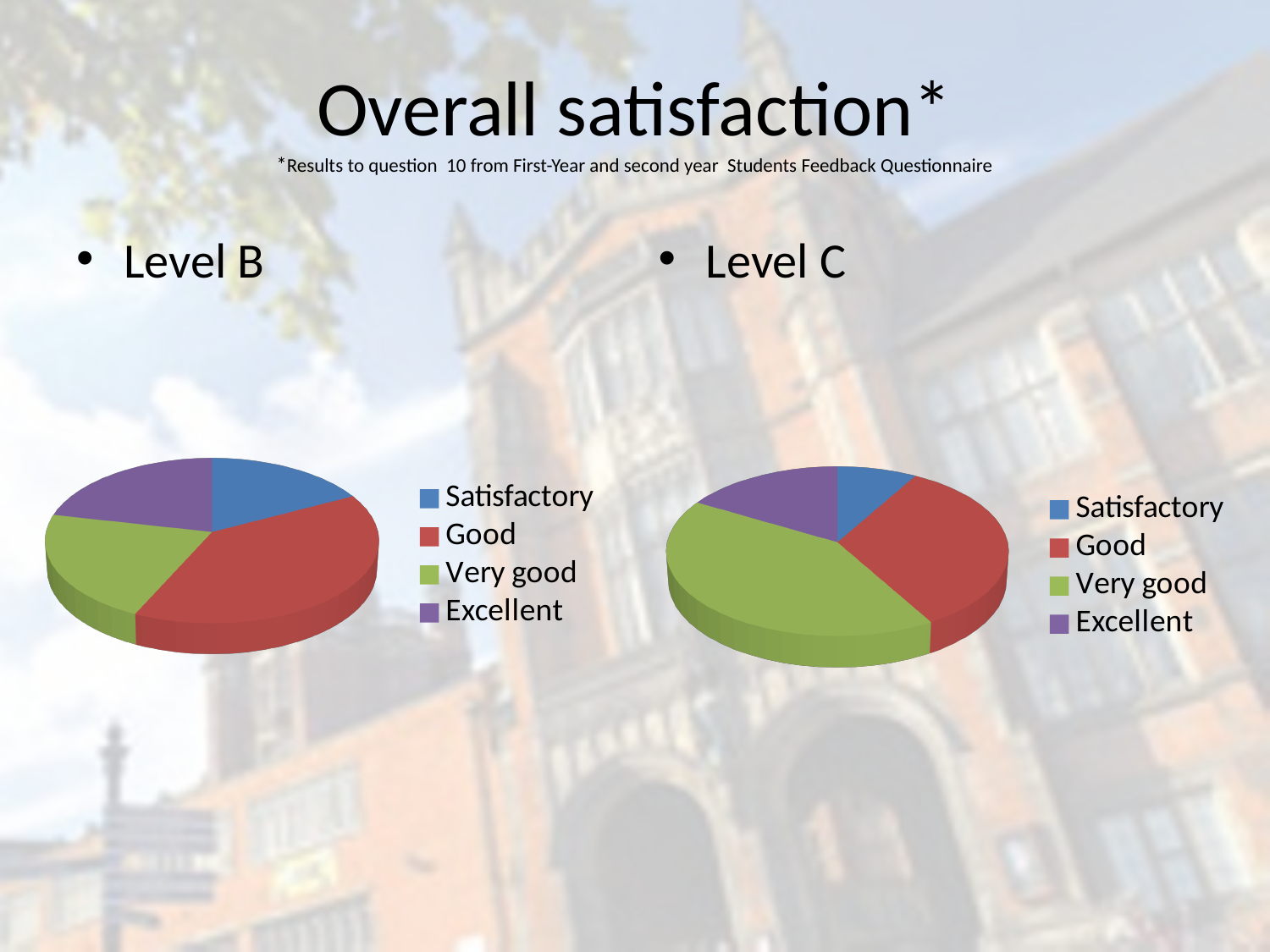
In the Level B chart, which category has the largest slice? Good How many slices does the Level B pie chart have? 4 What is the title of the slide containing the two pie charts? Overall satisfaction* In the Level C chart, which category has the largest slice? Very good In the Level B chart, which slice is larger: Very good or Satisfactory? Very good In the Level B chart, what colour represents the Excellent category? purple In the Level B chart, which category has the smallest slice? Satisfactory How many entries does the legend of the Level C chart list? 4 What kind of chart is the Level C chart? pie chart In the Level C chart, which slice is larger: Good or Excellent? Good What kind of chart is the Level B chart? pie chart In the Level C chart, which category has the smallest slice? Satisfactory